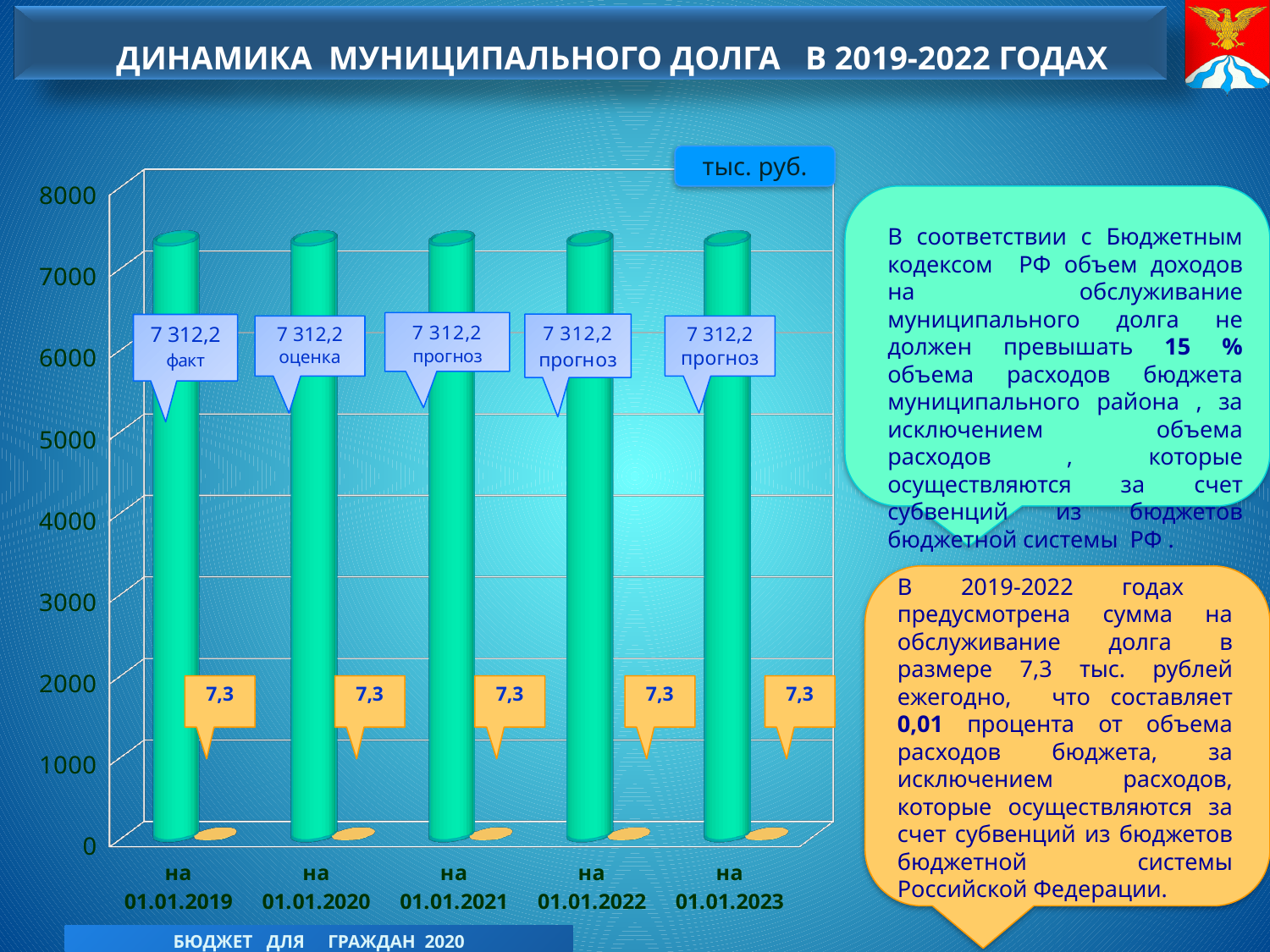
What is the debt servicing value shown in the orange label for на 01.01.2021? 7,3 How many dates are shown along the x axis of the chart? 5 What is the municipal debt value shown for на 01.01.2023? 7 312,2 Which is larger for на 01.01.2022: the municipal debt value (7 312,2) or the debt servicing value (7,3)? 7 312,2 Is the municipal debt value for на 01.01.2020 greater or less than 7000? greater What kind of chart is shown on the slide? bar chart What status label accompanies the value for на 01.01.2020? оценка What is the highest value printed on the vertical axis of the chart? 8000 What is the difference between the municipal debt value and the debt servicing value for на 01.01.2019? 7 304,9 What unit of measurement is shown in the box above the chart? тыс. руб. Do the municipal debt values rise, fall or stay the same from на 01.01.2019 to на 01.01.2023? stay the same What is the municipal debt value shown for на 01.01.2019? 7 312,2